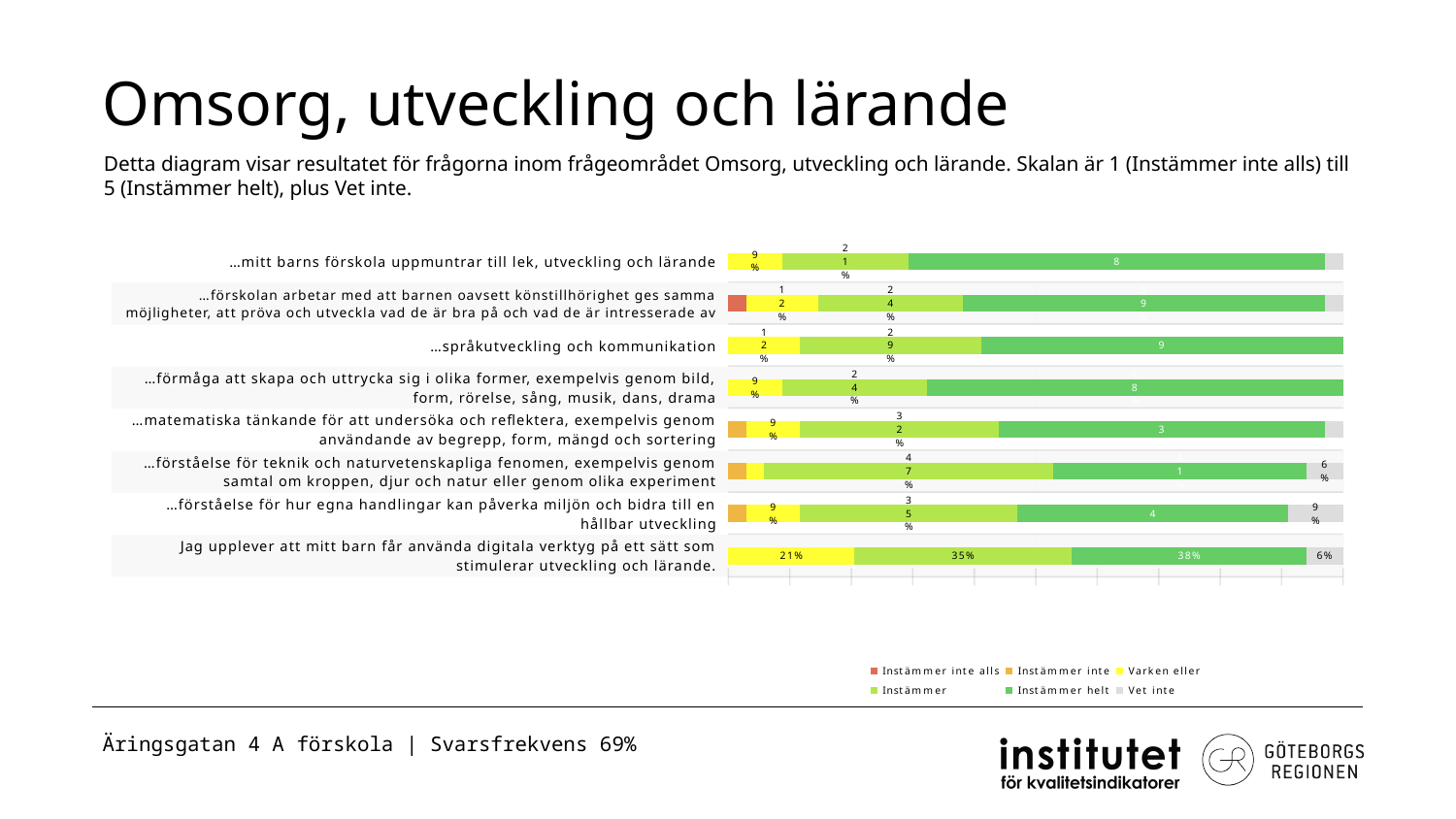
For the statement 'Jag upplever att mitt barn får använda digitala verktyg på ett sätt som stimulerar utveckling och lärande', what is the value for Varken eller? 21% How many series does the legend list? 6 For the statement about digitala verktyg, what is the difference between Instämmer helt and Varken eller? 17% Which series in the legend is shown in red? Instämmer inte alls For the statement 'Jag upplever att mitt barn får använda digitala verktyg på ett sätt som stimulerar utveckling och lärande', what is the value for Vet inte? 6% For the statement 'Jag upplever att mitt barn får använda digitala verktyg på ett sätt som stimulerar utveckling och lärande', what is the value for Instämmer helt? 38% What kind of chart is shown on the slide? Stacked bar chart For the statement 'Jag upplever att mitt barn får använda digitala verktyg på ett sätt som stimulerar utveckling och lärande', what is the value for Instämmer? 35% For the statement about digitala verktyg, which response category has the largest share? Instämmer helt For the statement about digitala verktyg, which is larger: Instämmer or Instämmer helt? Instämmer helt How many question statements (categories) are plotted in the chart? 8